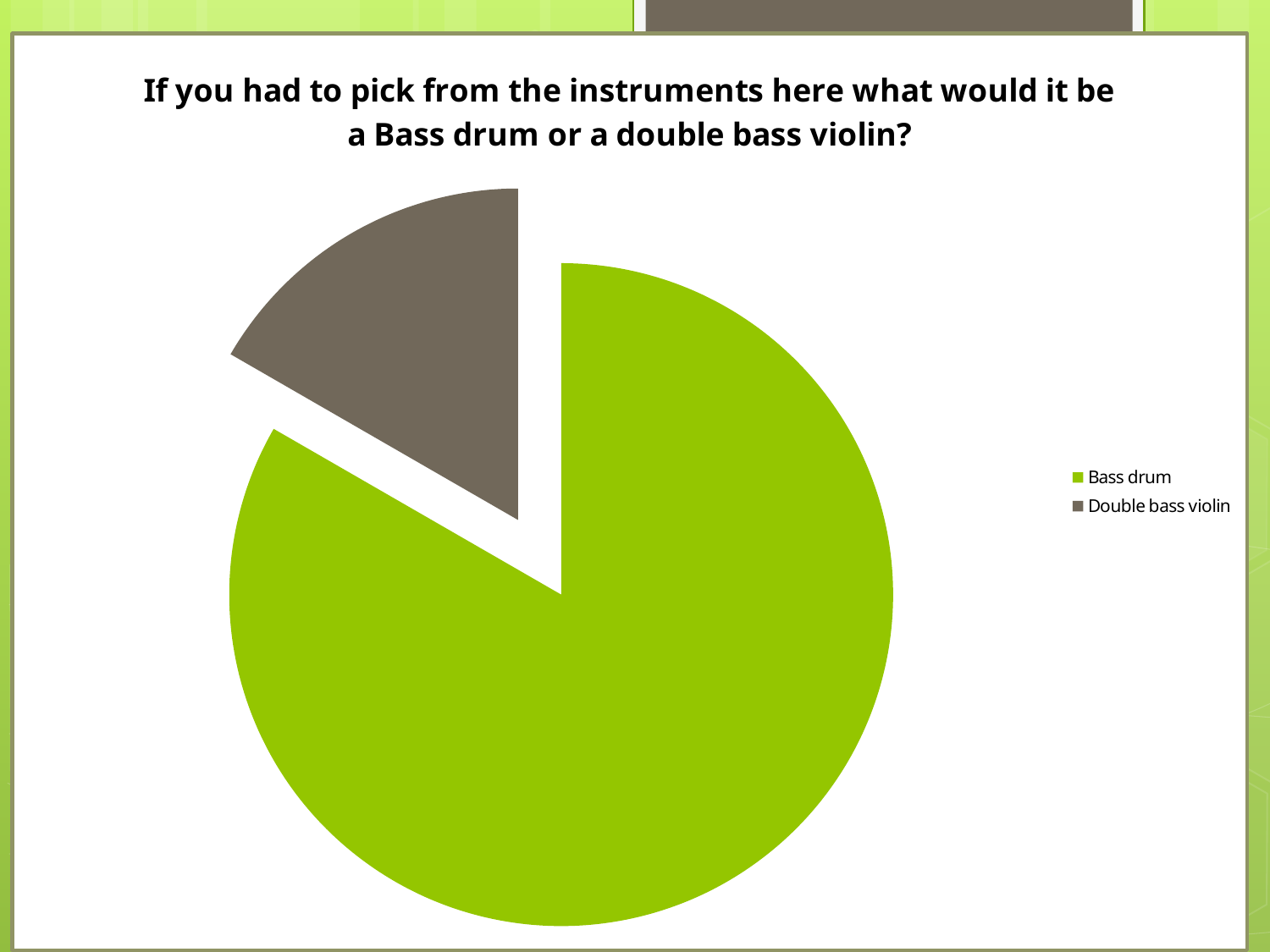
Which slice is larger, Bass drum or Double bass violin? Bass drum How many slices does the pie chart have? 2 How many entries does the legend list? 2 What colour is the Bass drum slice? green Which instrument has the largest slice of the pie? Bass drum What kind of chart is shown on the slide? pie chart Which instrument has the smallest slice of the pie? Double bass violin What colour is the Double bass violin slice? grey